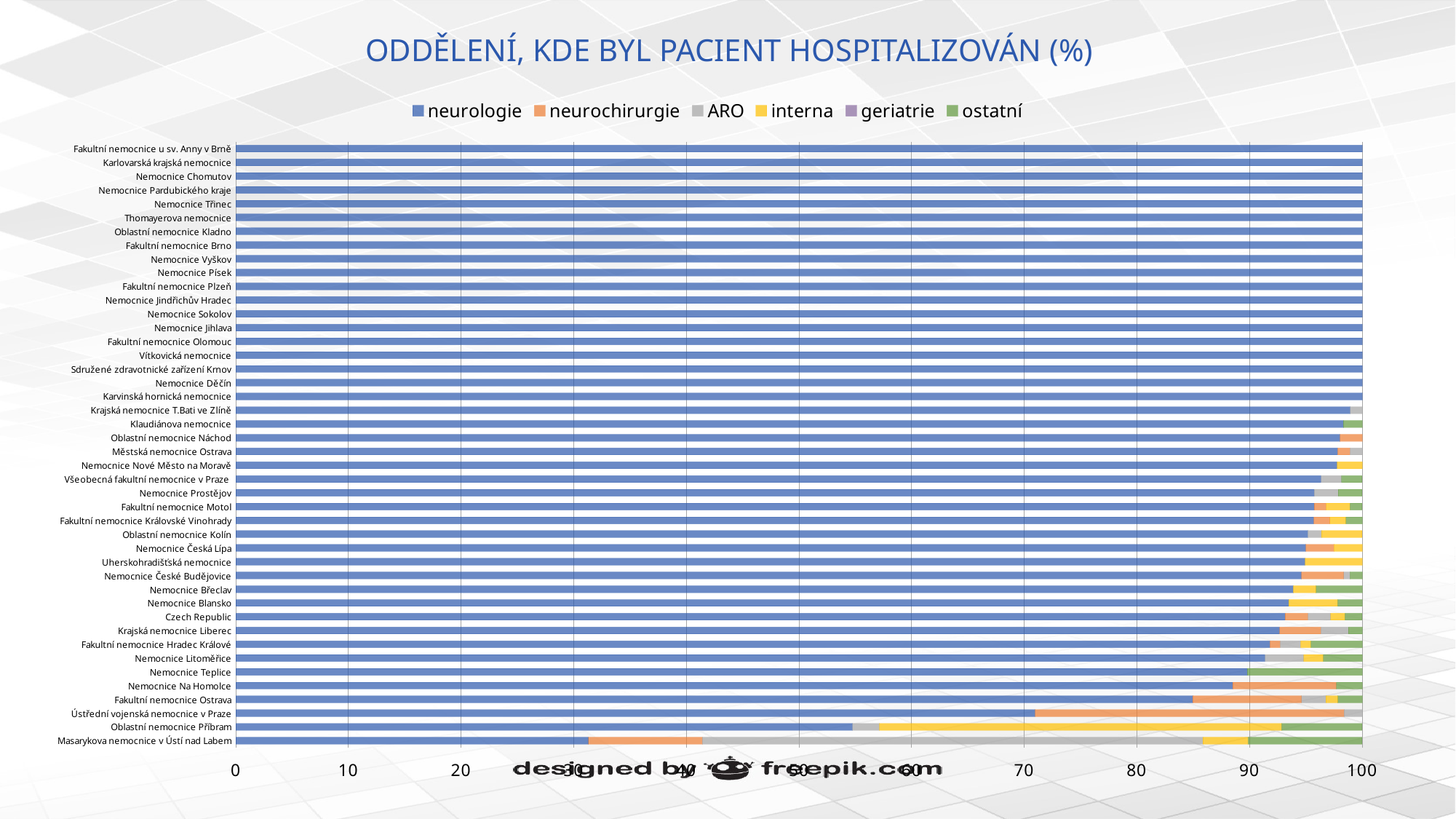
Is the neurologie value for Masarykova nemocnice v Ústí nad Labem greater or less than 40? less How many hospitals (categories) are plotted on the chart? 44 Which hospital has the largest interna share? Oblastní nemocnice Příbram What is the total of the stacked bar for Nemocnice Teplice? 100 How many series does the legend list? 6 Is the neurologie value for Ústřední vojenská nemocnice v Praze greater or less than 60? greater Which hospital has the lowest neurologie share? Masarykova nemocnice v Ústí nad Labem Which has the larger neurologie share, Oblastní nemocnice Příbram or Masarykova nemocnice v Ústí nad Labem? Oblastní nemocnice Příbram What is the title of the chart? ODDĚLENÍ, KDE BYL PACIENT HOSPITALIZOVÁN (%) Is the neurologie value for Fakultní nemocnice Ostrava greater or less than 90? less What kind of chart is shown on the slide? Stacked bar chart